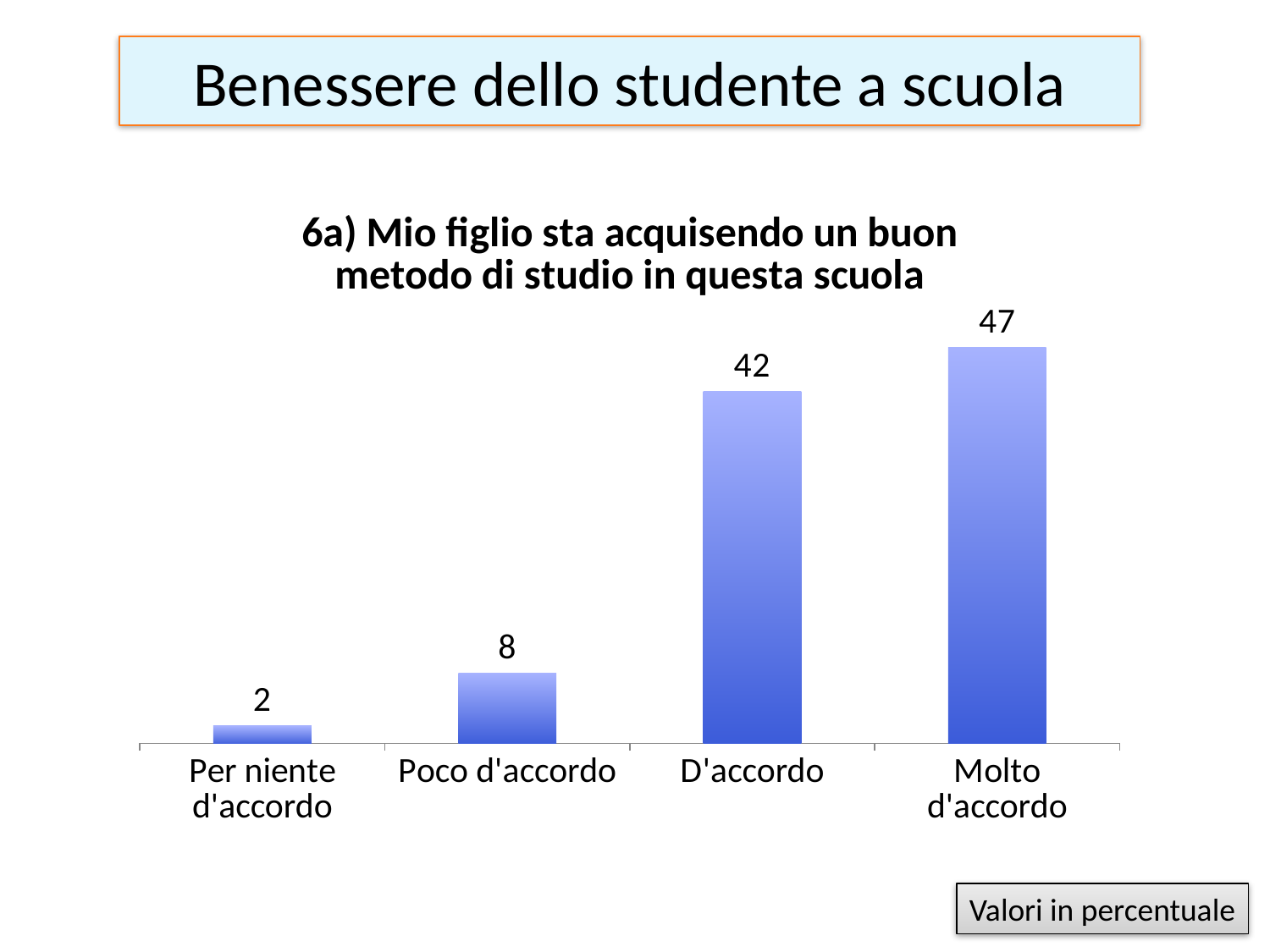
Which category has the lowest value? Per niente d'accordo Which category has the highest value? Molto d'accordo What is the value for "D'accordo"? 42 Which is larger, the value for "Poco d'accordo" or the value for "D'accordo"? D'accordo What is the value for "Poco d'accordo"? 8 What kind of chart is shown on the slide? Bar chart What is the title of the chart? 6a) Mio figlio sta acquisendo un buon metodo di studio in questa scuola How many categories are shown on the x axis? 4 What is the value for "Molto d'accordo"? 47 What is the value for "Per niente d'accordo"? 2 What is the difference between the values for "Molto d'accordo" and "D'accordo"? 5 What is the difference between the values for "Poco d'accordo" and "Per niente d'accordo"? 6